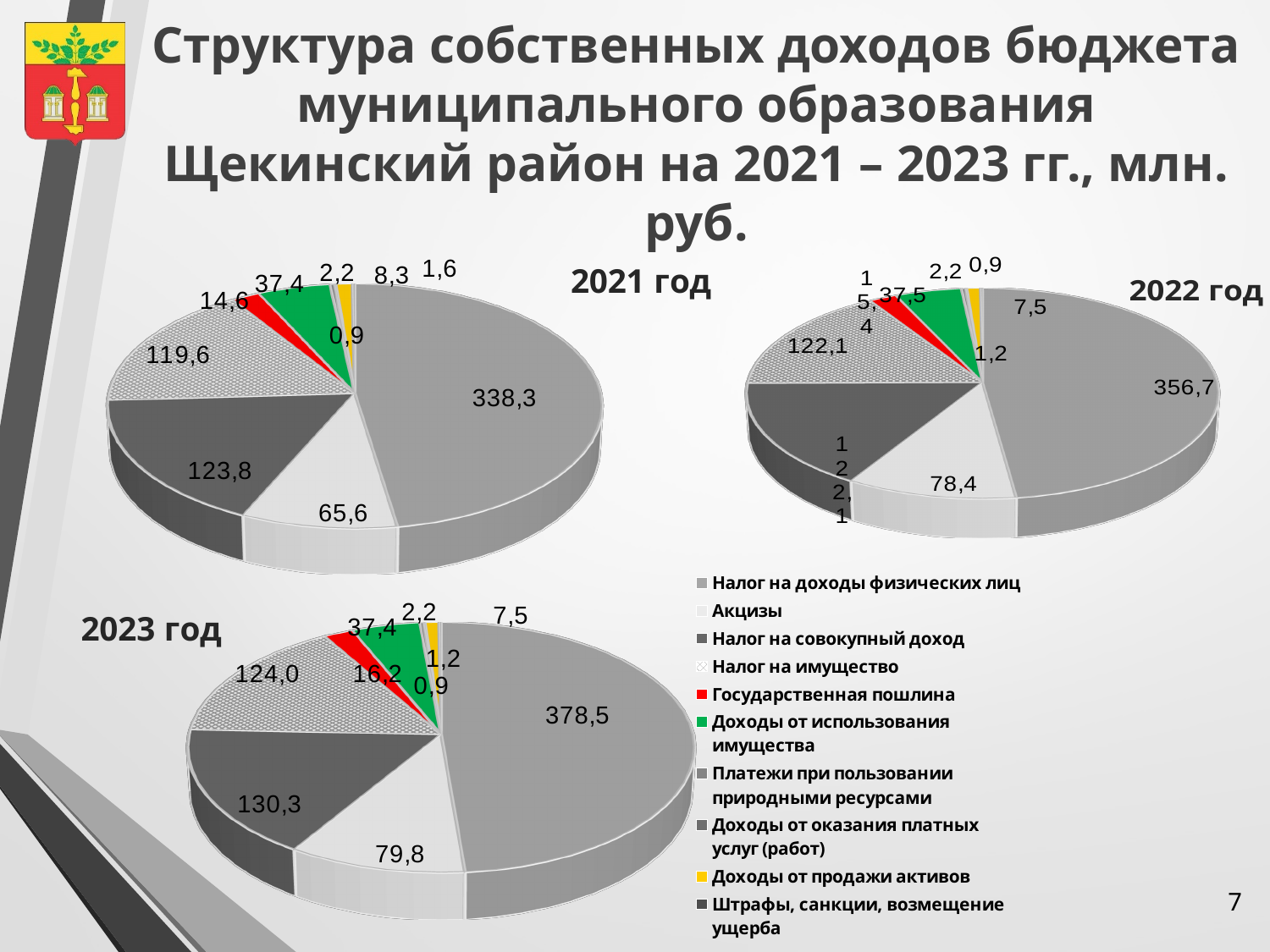
On the 2023 год chart, which category has the largest slice? Налог на доходы физических лиц On the 2023 год chart, what is the difference between Налог на совокупный доход (130,3) and Акцизы (79,8)? 50,5 On the 2021 год chart, what is the value for Налог на доходы физических лиц? 338,3 How many categories does the legend list? 10 How many pie charts are shown on the slide? 3 On the 2022 год chart, what is the value for Налог на доходы физических лиц? 356,7 On the 2023 год chart, what is the value for Акцизы? 79,8 On the 2023 год chart, what is the value for Государственная пошлина (the red slice)? 16,2 On the 2021 год chart, what is the difference between Налог на доходы физических лиц (338,3) and Акцизы (65,6)? 272,7 What kind of chart is used for the 2022 год data? Pie chart On the 2021 год chart, what is the value for Доходы от использования имущества (the green slice)? 37,4 On the 2021 год chart, which is larger: Налог на совокупный доход or Налог на имущество? Налог на совокупный доход